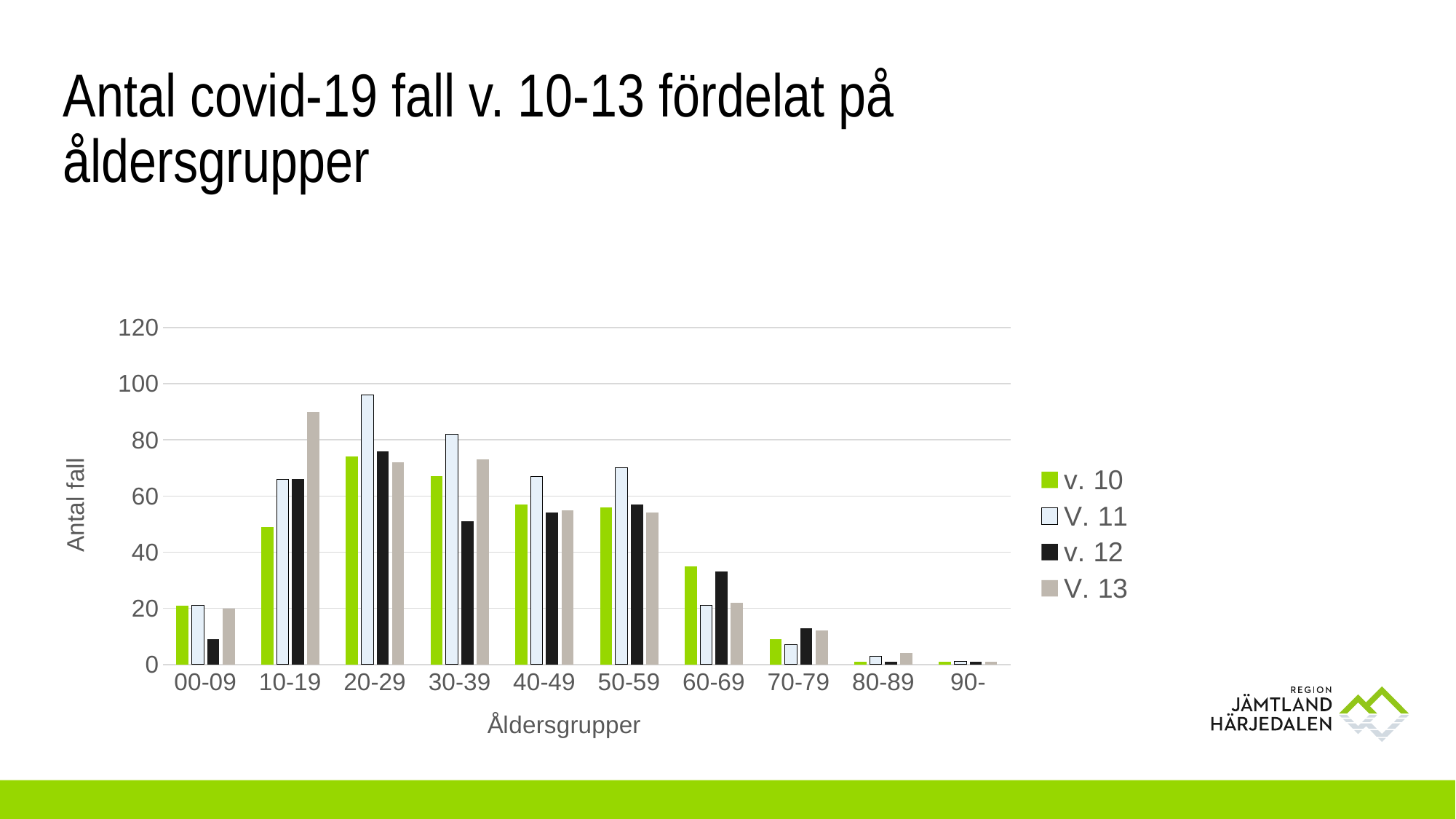
Is the v. 12 value for 00-09 greater or less than 20? less Is the V. 13 value for 10-19 greater or less than 80? greater In the 10-19 age group, which series has the highest bar? V. 13 What kind of chart is shown on the slide? bar chart Is the V. 11 value for 20-29 greater or less than 80? greater How many age groups are shown on the x axis? 10 In the 30-39 age group, which is larger: V. 11 or v. 12? V. 11 In the 60-69 age group, which is larger: v. 10 or V. 11? v. 10 How many series does the legend list? 4 Do the v. 10 values rise or fall from 50-59 to 90-? fall What is the title of the vertical axis? Antal fall Which age group has the highest V. 11 bar? 20-29